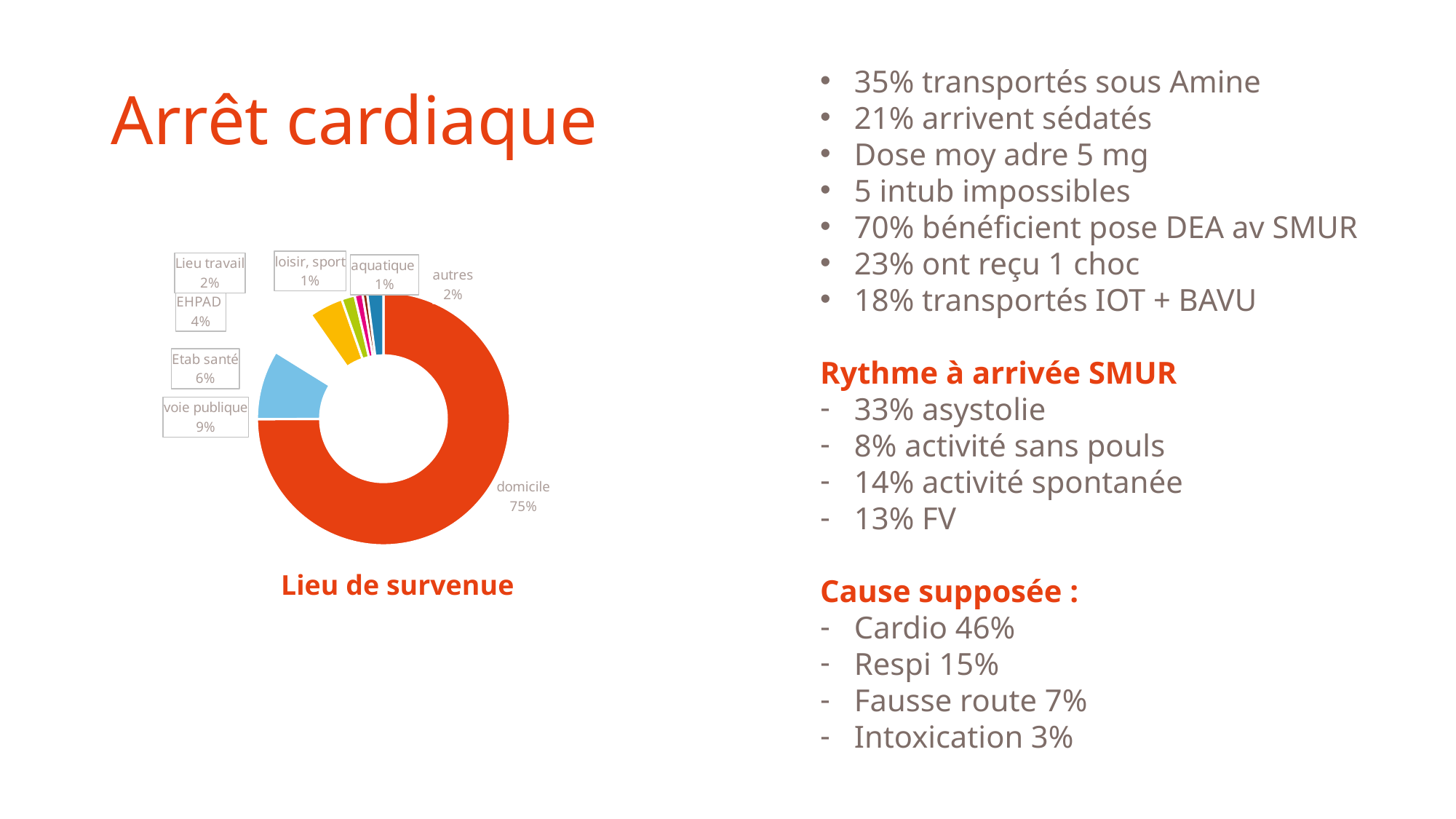
What is the difference between the domicile and voie publique shares in the "Lieu de survenue" chart? 66% What is the difference between the voie publique and Etab santé shares in the "Lieu de survenue" chart? 3% What is the value for EHPAD in the "Lieu de survenue" chart? 4% What is the value for Etab santé in the "Lieu de survenue" chart? 6% In the "Lieu de survenue" chart, which is larger: Etab santé or EHPAD? Etab santé What is the title of the chart on the slide? Lieu de survenue What share of the "Lieu de survenue" chart is domicile? 75% Which category has the largest share in the "Lieu de survenue" chart? domicile What is the value for Lieu travail in the "Lieu de survenue" chart? 2% What kind of chart is "Lieu de survenue"? Doughnut chart How many categories are shown in the "Lieu de survenue" chart? 8 What is the value for voie publique in the "Lieu de survenue" chart? 9%